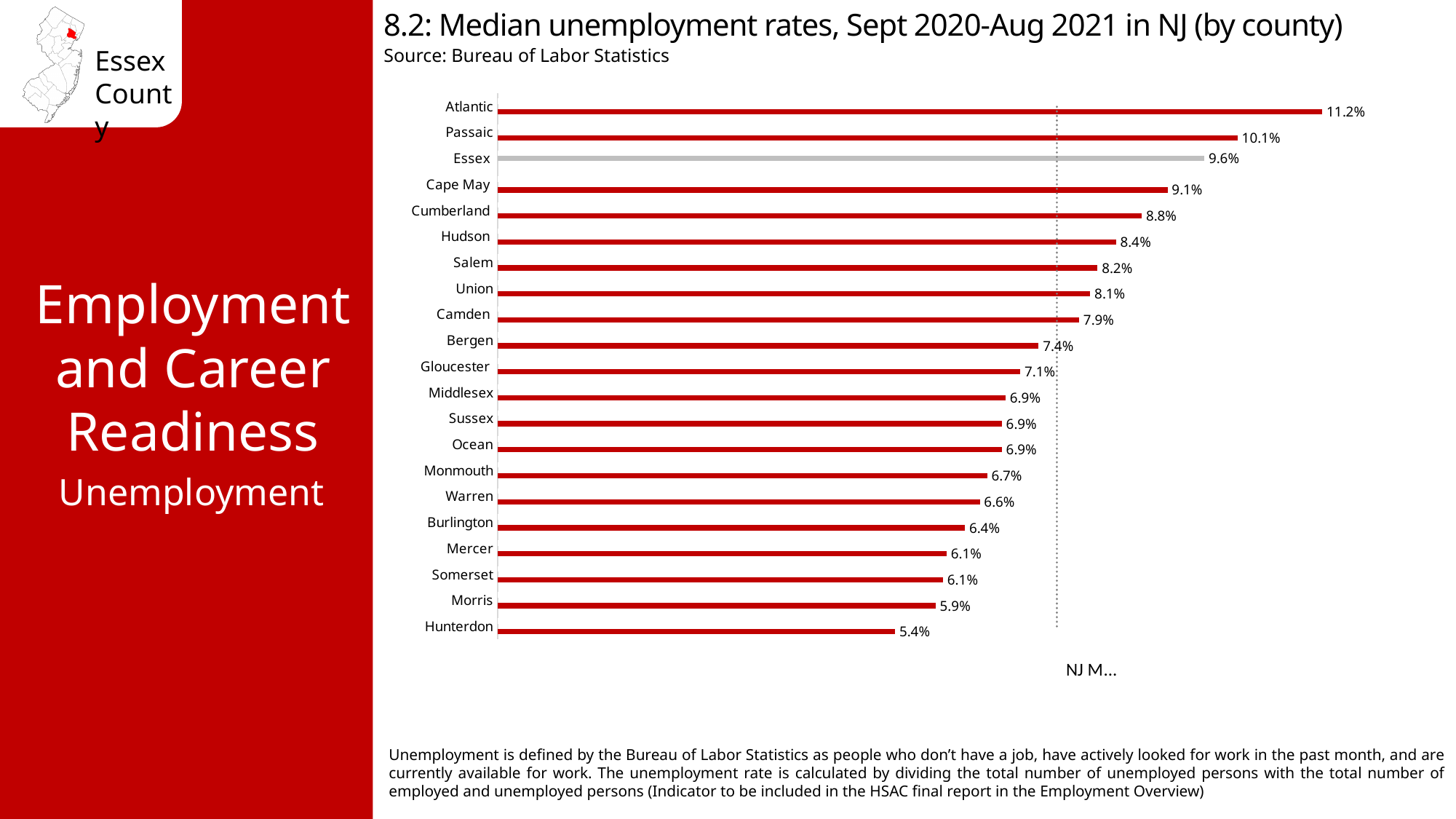
Which county's bar is coloured grey instead of red? Essex What is the median unemployment rate for Hunterdon county? 5.4% What is the difference between the median unemployment rates of Essex and Hunterdon counties? 4.2% What kind of chart is shown on the slide? Bar chart Which county has a higher median unemployment rate, Bergen or Morris? Bergen How many counties are shown in the chart? 21 What is the difference between the median unemployment rates of Atlantic and Passaic counties? 1.1% Which county has the lowest median unemployment rate? Hunterdon Which county has a higher median unemployment rate, Cape May or Camden? Cape May Which county has the highest median unemployment rate? Atlantic What is the median unemployment rate for Hudson county? 8.4% What is the median unemployment rate for Essex county? 9.6%